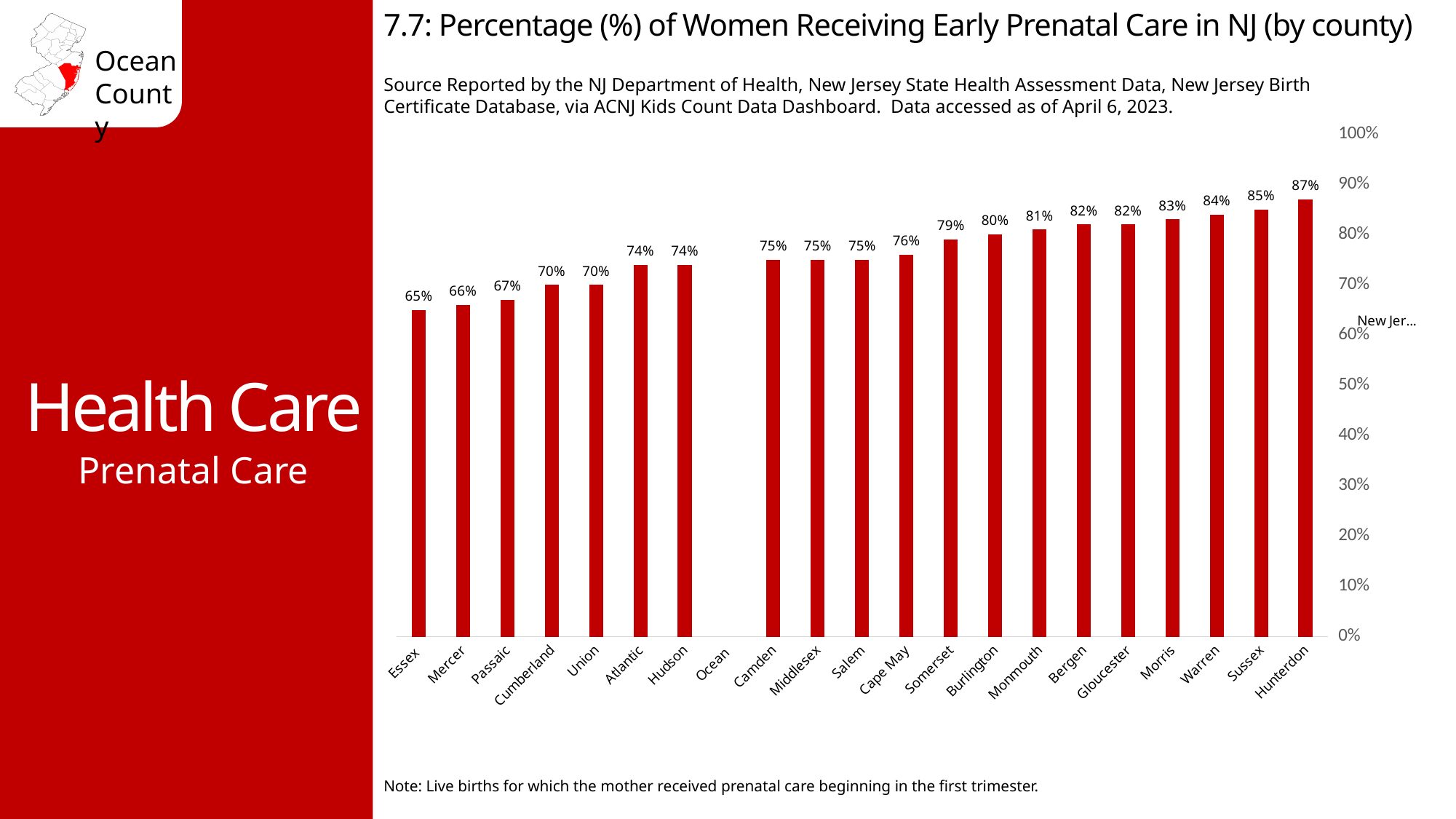
Among the counties with a bar shown, which has the lowest percentage? Essex What kind of chart is shown on the slide? Bar chart Which county has the highest percentage of women receiving early prenatal care? Hunterdon Do the values generally rise or fall moving from left to right along the x axis? Rise What percentage of women received early prenatal care in Essex County? 65% How many county labels appear along the x axis? 21 Which county has a higher percentage, Bergen or Cape May? Bergen Which county on the x axis has no bar plotted? Ocean Is the value for Monmouth greater or less than 80%? greater What is the value shown for Hunterdon County? 87% What is the difference between the percentages for Hunterdon and Essex? 22% What percentage is shown for Somerset County? 79%